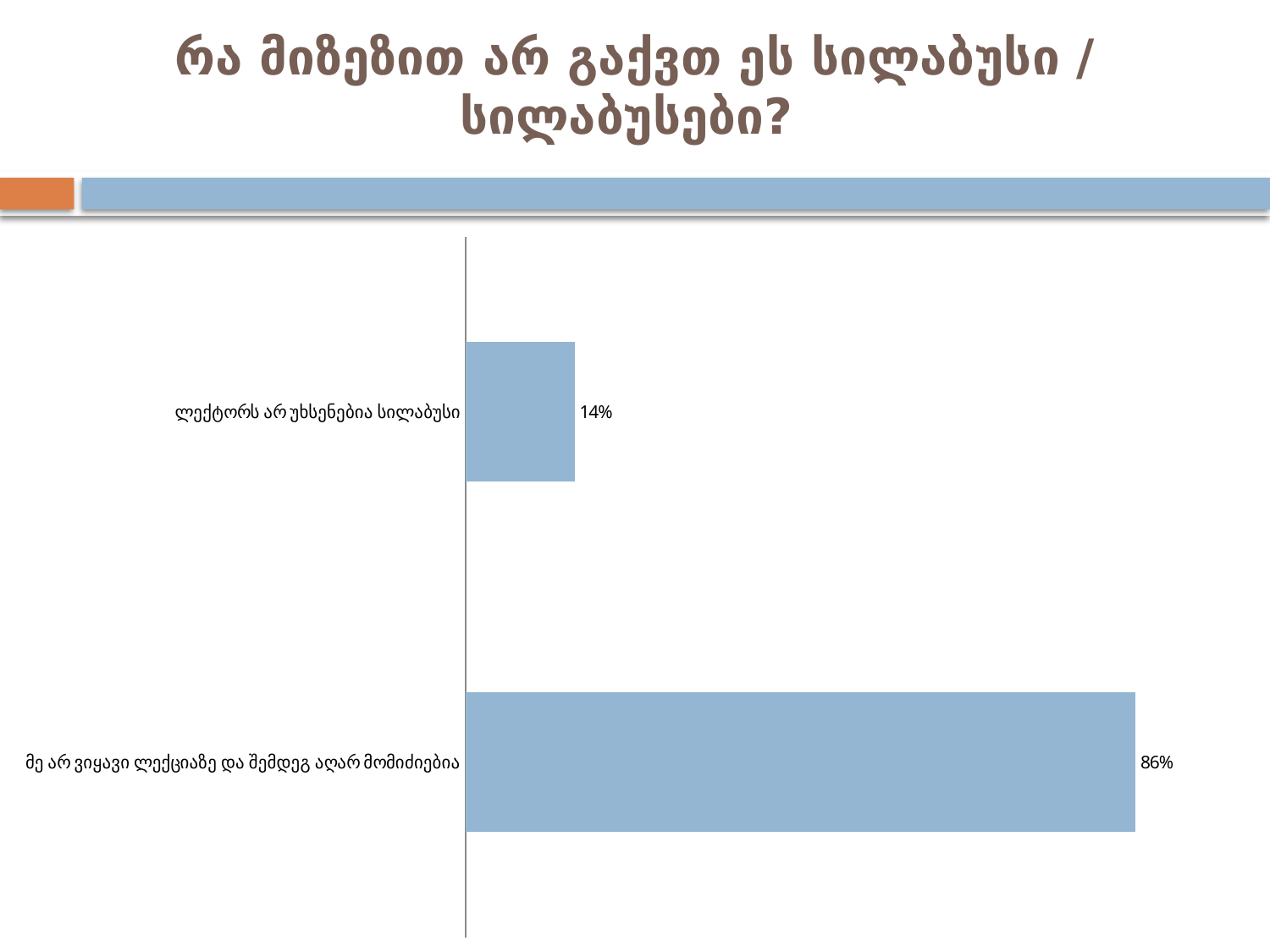
What value is shown for the category "მე არ ვიყავი ლექციაზე და შემდეგ აღარ მომიძებია"? 86% What is the title of the slide? რა მიზეზით არ გაქვთ ეს სილაბუსი / სილაბუსები? What kind of chart is shown on the slide? Bar chart What value is shown for the category "ლექტორს არ უხსენებია სილაბუსი"? 14% What is the difference between the values for "მე არ ვიყავი ლექციაზე და შემდეგ აღარ მომიძებია" and "ლექტორს არ უხსენებია სილაბუსი"? 72% What colour are the bars in the chart? Light blue Which category has the lowest value? ლექტორს არ უხსენებია სილაბუსი Which is larger: the value for "ლექტორს არ უხსენებია სილაბუსი" or the value for "მე არ ვიყავი ლექციაზე და შემდეგ აღარ მომიძებია"? მე არ ვიყავი ლექციაზე და შემდეგ აღარ მომიძიებია What is the total of the two values shown in the chart? 100% How many categories are shown in the chart? 2 Which category has the highest value? მე არ ვიყავი ლექციაზე და შემდეგ აღარ მომიძიებია